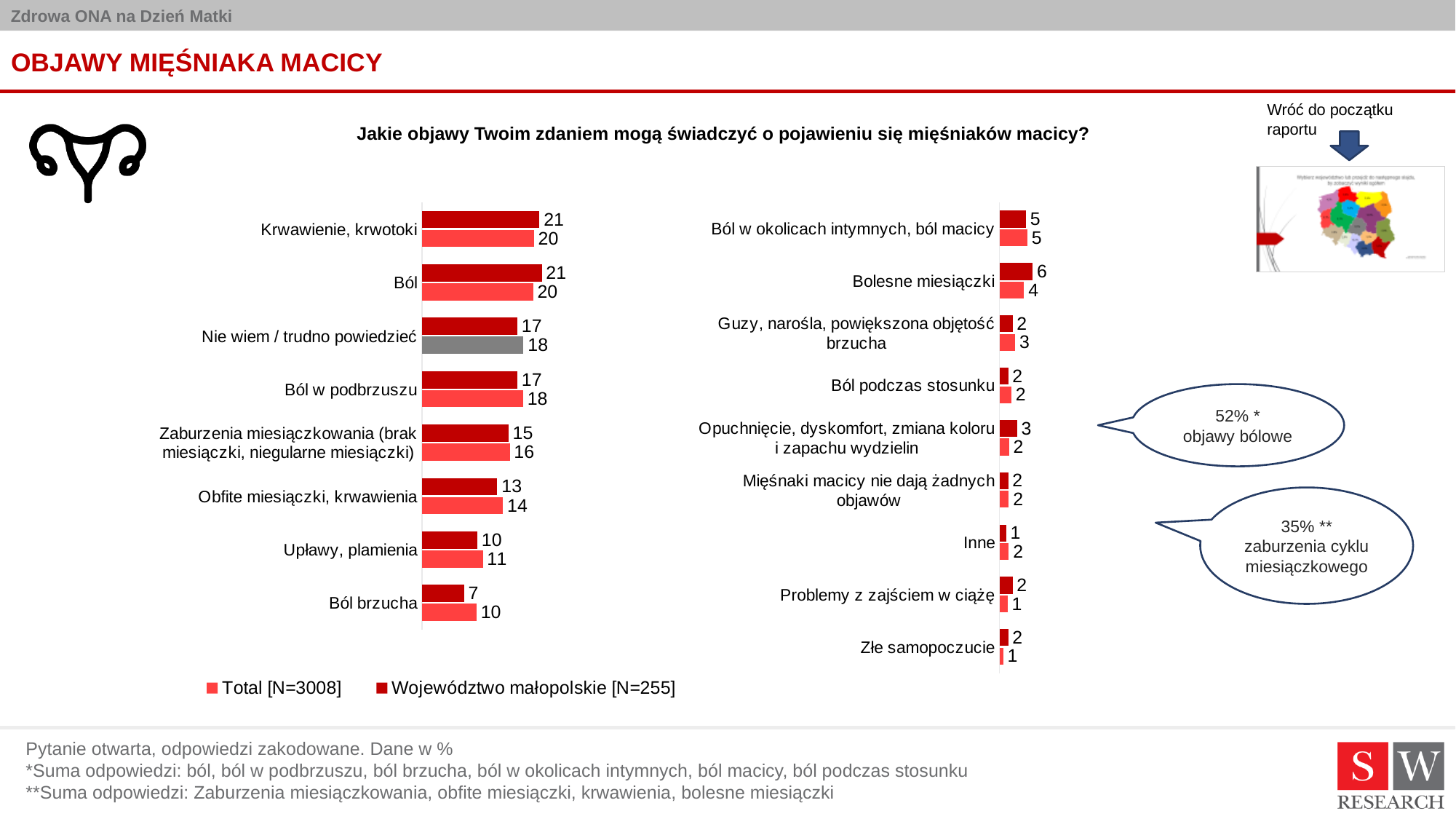
How many categories are shown in the left chart? 8 In the left chart, what is the difference between the Total [N=3008] and Województwo małopolskie [N=255] values for Ból brzucha? 3 What type of chart is the left chart? Bar chart In the right chart, which is larger for Bolesne miesiączki: the Total [N=3008] value or the Województwo małopolskie [N=255] value? Województwo małopolskie [N=255] In the left chart, what is the Województwo małopolskie [N=255] value for Upławy, plamienia? 10 In the left chart, what is the Total [N=3008] value for Ból brzucha? 10 In the right chart, what is the Total [N=3008] value for Guzy, narośla, powiększona objętość brzucha? 3 In the right chart, what is the Województwo małopolskie [N=255] value for Bolesne miesiączki? 6 How many series does the legend list? 2 In the right chart, which category has the highest Województwo małopolskie [N=255] value? Bolesne miesiączki In the left chart, which category has the lowest Województwo małopolskie [N=255] value? Ból brzucha How many categories are shown in the right chart? 9